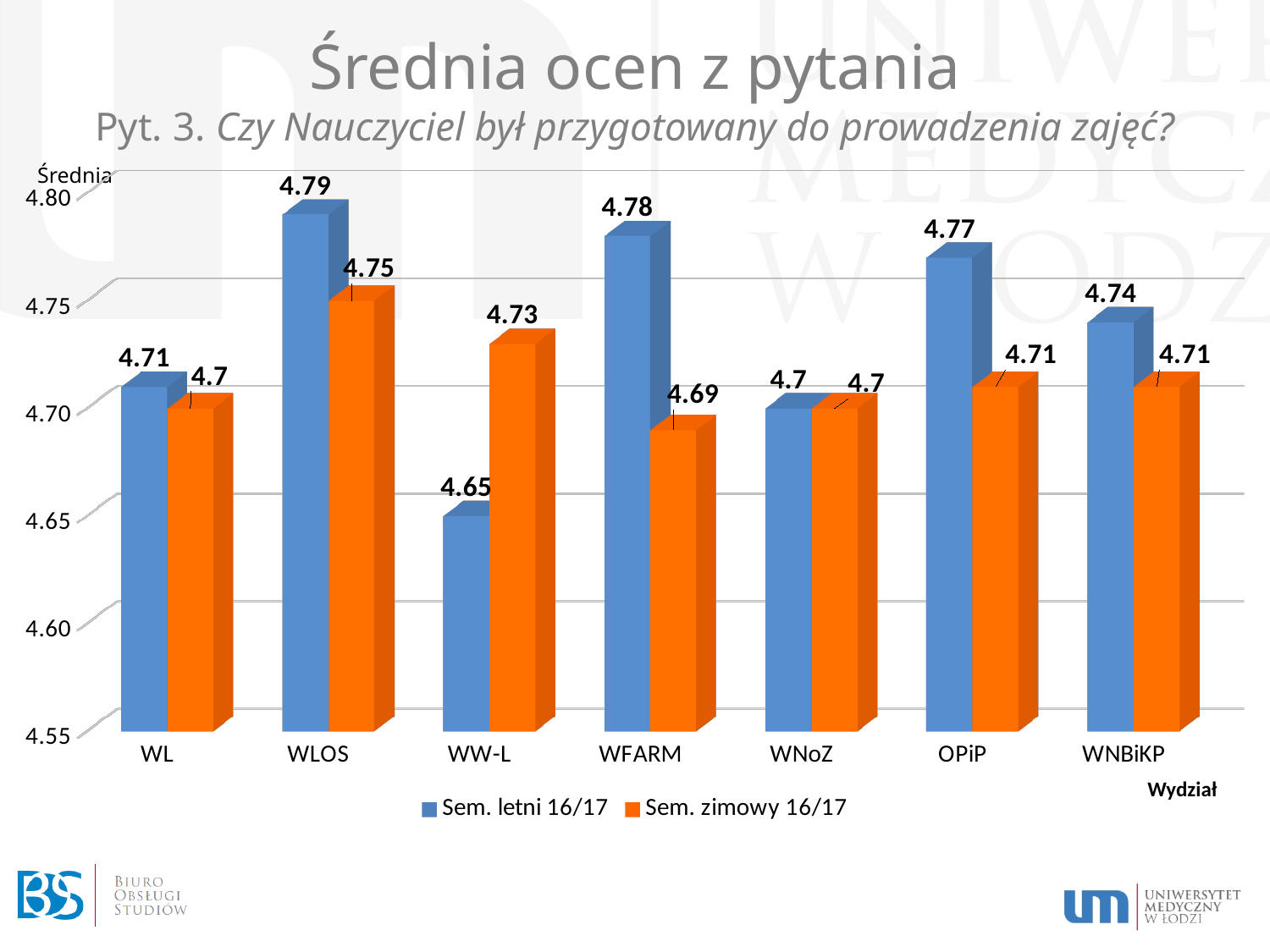
What is the value for WLOS in the Sem. letni 16/17 series? 4.79 What is the value for OPiP in the Sem. letni 16/17 series? 4.77 How many faculties are shown on the x axis? 7 What is the difference between the Sem. letni 16/17 and Sem. zimowy 16/17 values for WFARM? 0.09 Which faculty has the lowest value in the Sem. letni 16/17 series? WW-L What kind of chart is shown on the slide? Bar chart What is the value for WW-L in the Sem. zimowy 16/17 series? 4.73 Which faculty has the highest value in the Sem. letni 16/17 series? WLOS Which faculty has the lowest value in the Sem. zimowy 16/17 series? WFARM For WW-L, which series has the larger value: Sem. letni 16/17 or Sem. zimowy 16/17? Sem. zimowy 16/17 Which series is shown in orange? Sem. zimowy 16/17 How many series does the legend list? 2